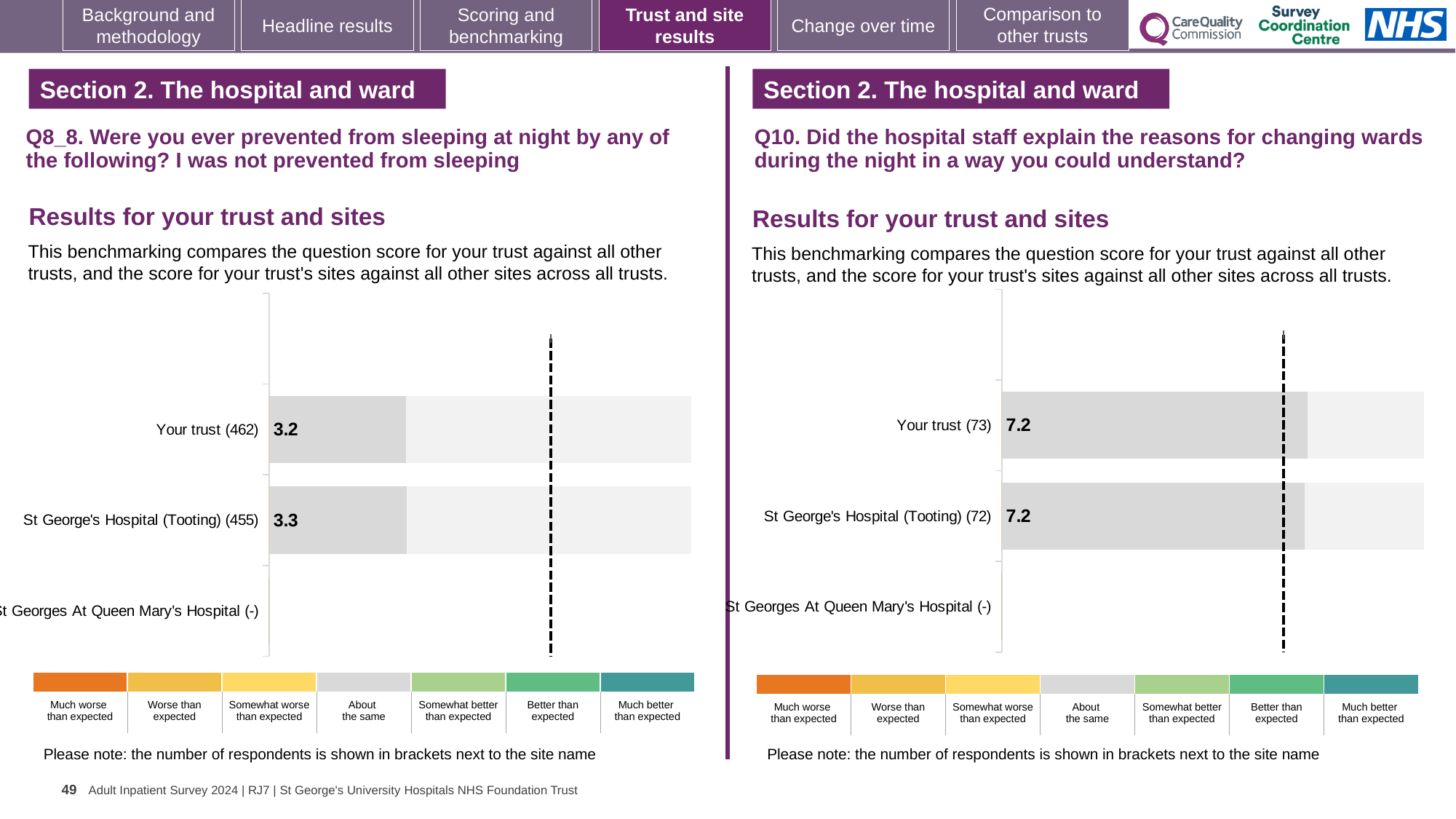
In the Q8_8 chart on the left, which has the higher score: Your trust or St George's Hospital (Tooting)? St George's Hospital (Tooting) In the Q10 chart on the right, is the score for Your trust higher than, lower than, or equal to the score for St George's Hospital (Tooting)? Equal In the Q8_8 chart on the left, what is the score for Your trust (462)? 3.2 In the Q8_8 chart on the left, how many respondents are shown for Your trust? 462 In the Q8_8 chart on the left, what is the difference between the score for St George's Hospital (Tooting) and the score for Your trust? 0.1 What kind of chart is used in the Q10 chart on the right? Bar chart In the Q10 chart on the right, what is the score for Your trust (73)? 7.2 In the Q8_8 chart on the left, what is the score for St George's Hospital (Tooting) (455)? 3.3 How many site/trust categories are listed on the y axis of the Q8_8 chart on the left? 3 In the Q8_8 chart on the left, which category has the highest score among those with a printed value? St George's Hospital (Tooting) (455) In the Q10 chart on the right, how many respondents are shown for St George's Hospital (Tooting)? 72 In the Q10 chart on the right, what is the score for St George's Hospital (Tooting) (72)? 7.2